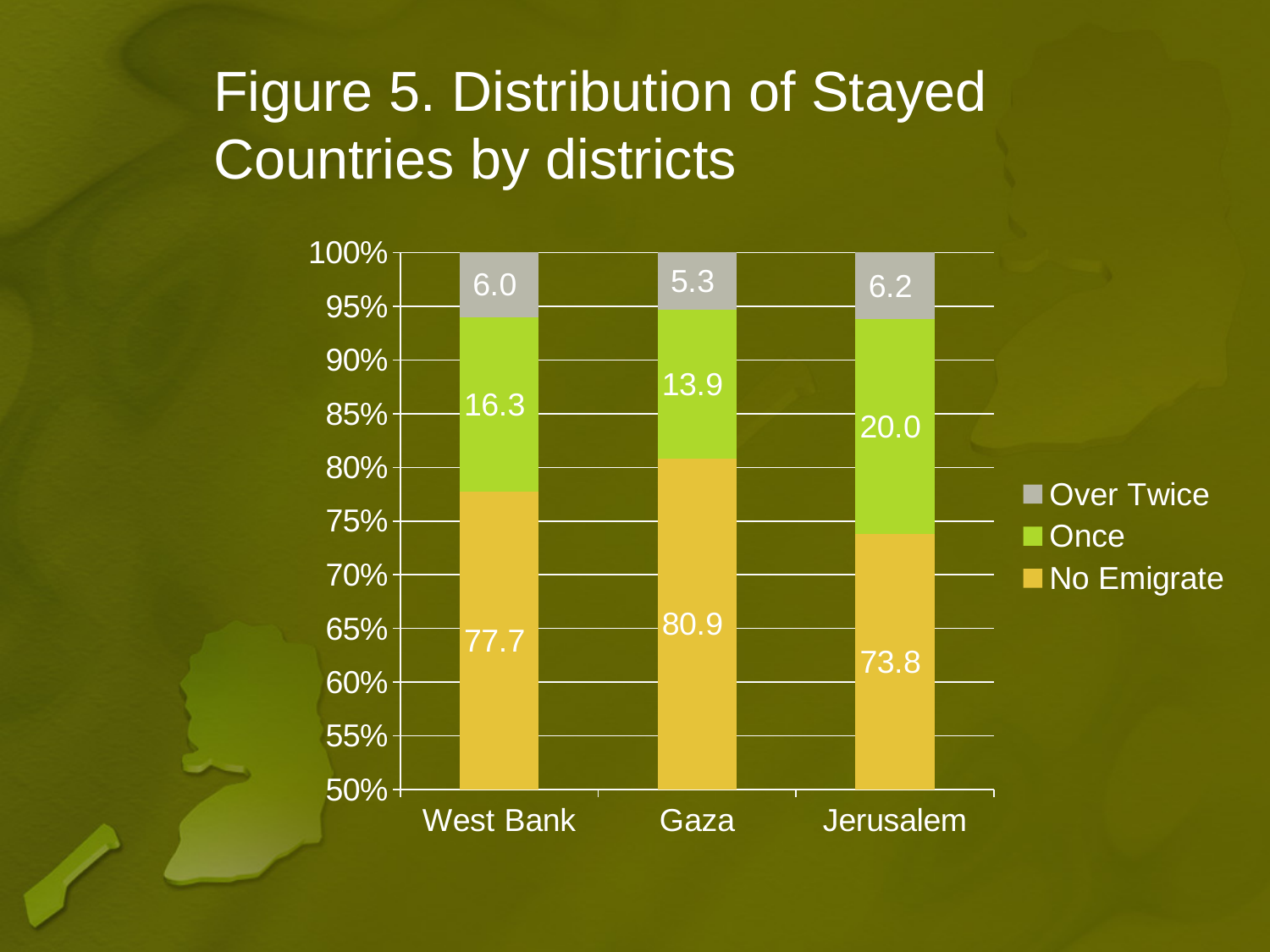
How many series does the legend list? 3 What is the title of the chart? Figure 5. Distribution of Stayed Countries by districts Which district has the lowest value for Once? Gaza What is the difference between the No Emigrate values for Gaza and Jerusalem? 7.1 What is the value for Over Twice in West Bank? 6.0 What is the value for No Emigrate in Gaza? 80.9 Which district has the lowest value for Over Twice? Gaza Which is larger, the Once value for West Bank or for Jerusalem? Jerusalem Which district has the highest value for No Emigrate? Gaza How many districts are shown on the x axis? 3 What is the value for Once in Jerusalem? 20.0 What kind of chart is shown on the slide? Stacked bar chart